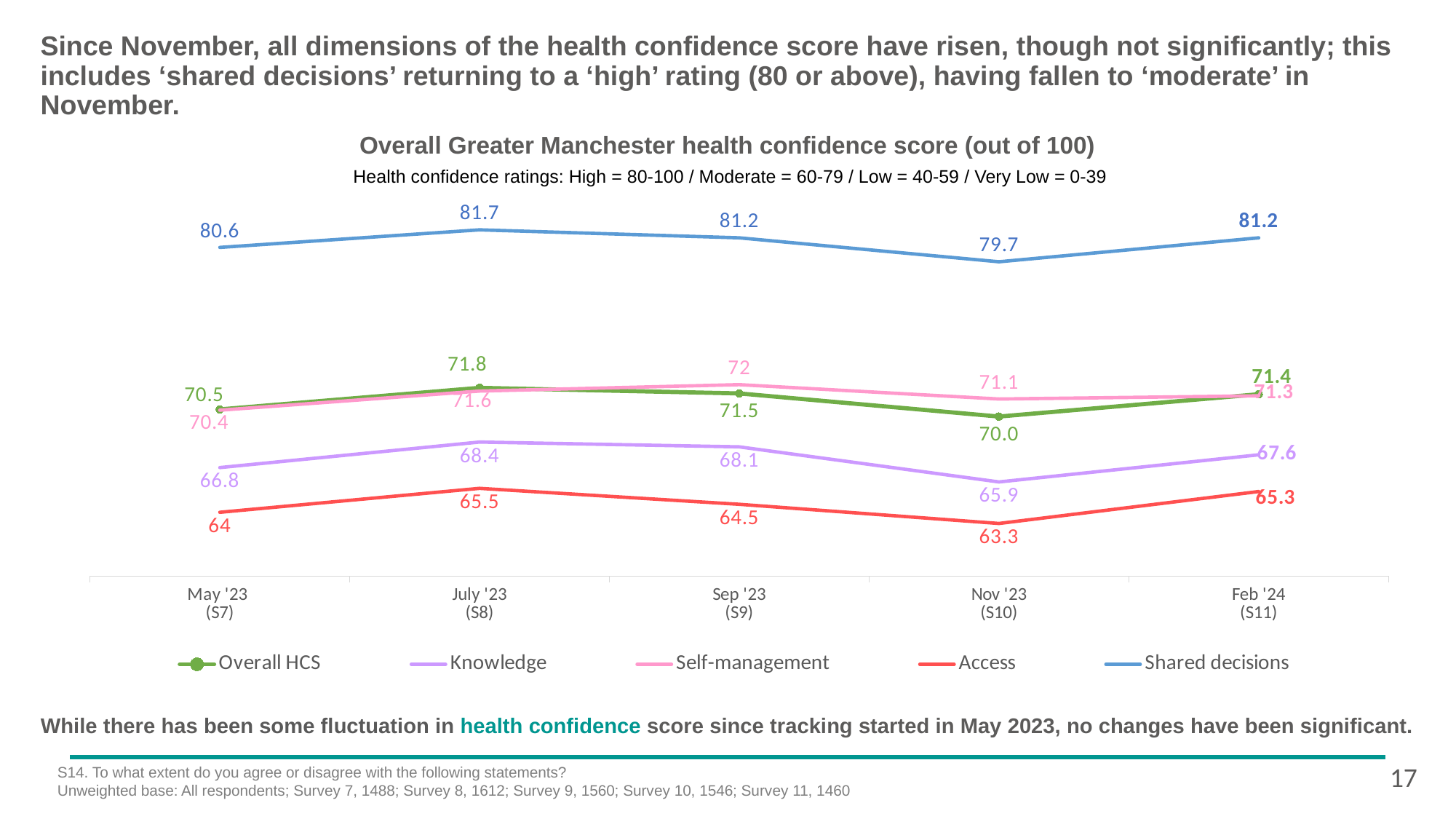
What kind of chart is shown on the slide? Line chart What is the Access score for May '23 (S7)? 64 How many series does the legend list? 5 What is the Overall HCS score for Feb '24 (S11)? 71.4 Which series is shown in blue in the legend? Shared decisions What is the Knowledge score for July '23 (S8)? 68.4 What is the difference between the Shared decisions score in Feb '24 (S11) and Nov '23 (S10)? 1.5 Which is larger in Feb '24 (S11): the Knowledge score or the Access score? Knowledge In which survey wave is the Access score lowest? Nov '23 (S10) In which survey wave is the Self-management score highest? Sep '23 (S9) How many survey waves are plotted on the x axis? 5 What is the Shared decisions score for Nov '23 (S10)? 79.7